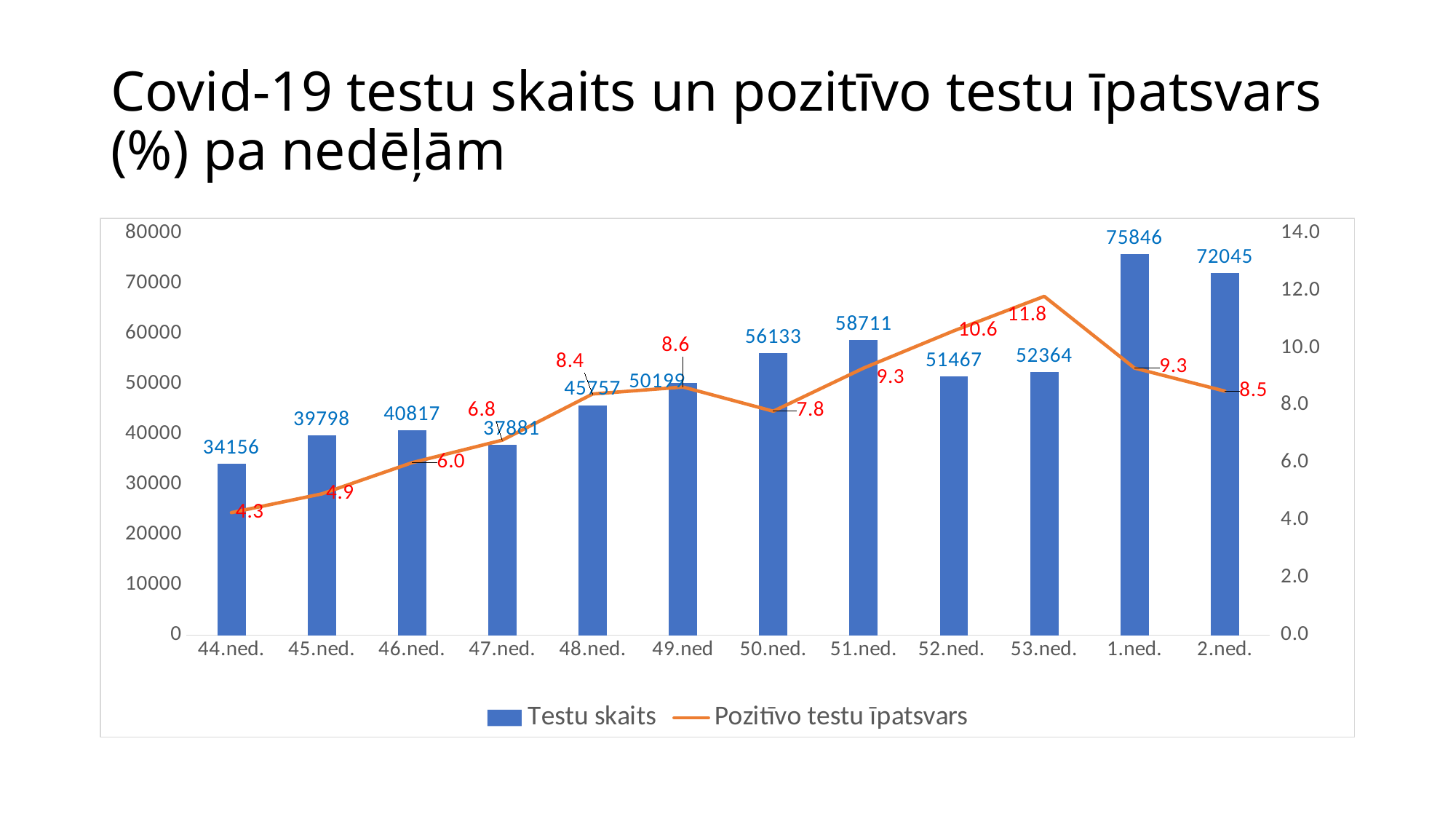
Does the Pozitīvo testu īpatsvars line rise or fall from 44.ned. to 53.ned.? rise Which week has the lowest Pozitīvo testu īpatsvars? 44.ned. What is the difference in Testu skaits between 1.ned. and 2.ned.? 3801 How many weeks are shown on the x axis? 12 Which is larger, the Testu skaits for 52.ned. or for 53.ned.? 53.ned. What kind of chart is shown on the slide? Combined bar and line chart How many series does the legend list? 2 What is the Pozitīvo testu īpatsvars value for 53.ned.? 11.8 Which week has the highest Testu skaits? 1.ned. Is the Testu skaits for 47.ned. greater or less than 40000? less What is the value of Testu skaits for 50.ned.? 56133 What is the value of Testu skaits for 44.ned.? 34156